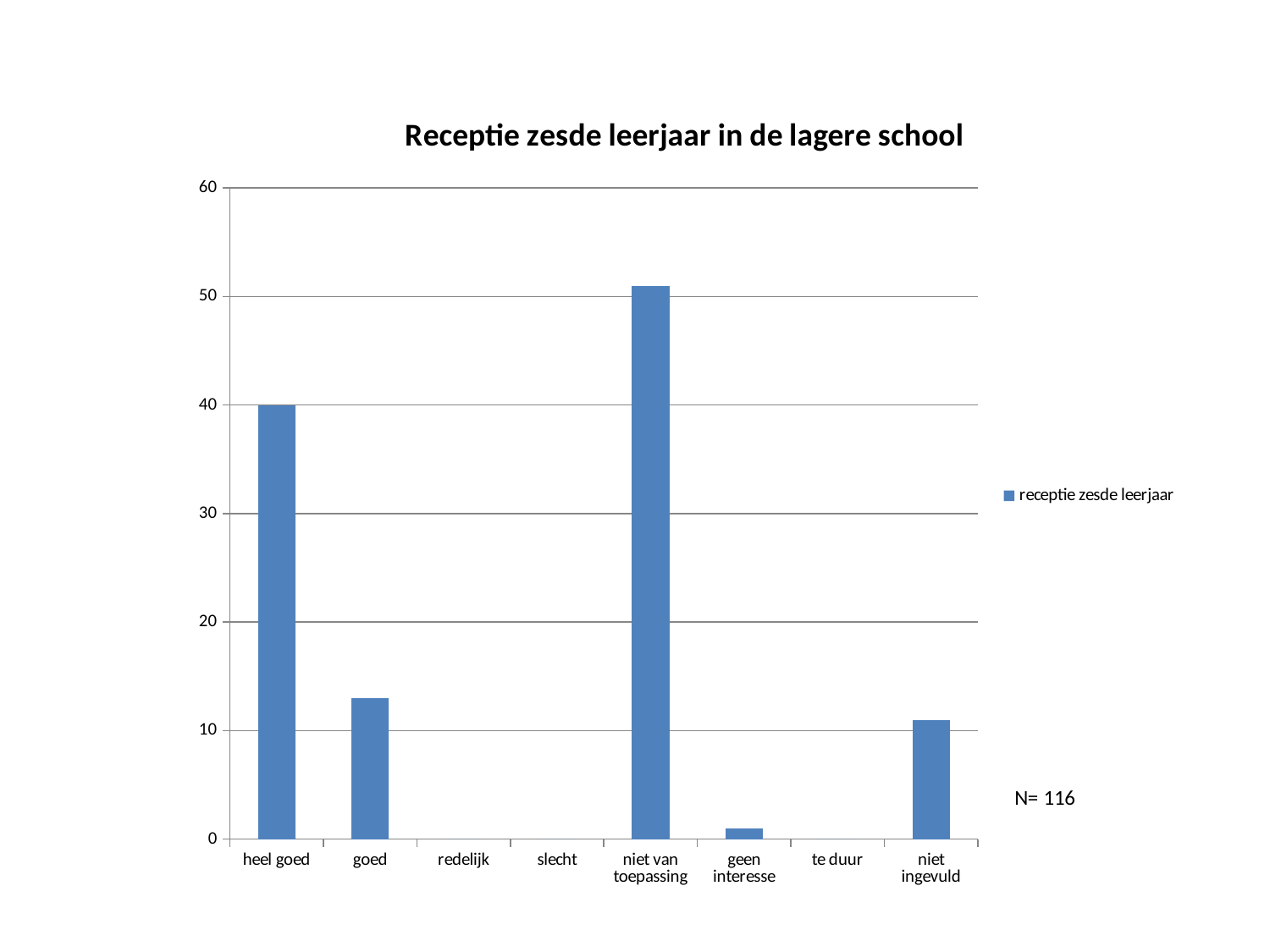
How many series does the legend list? 1 Is the value for 'geen interesse' greater or less than 10? less What is the value for 'heel goed'? 40 Is the value for 'niet van toepassing' greater or less than 50? greater What is the N value shown next to the chart? N= 116 Which category has the highest value? niet van toepassing What type of chart is shown on the slide? bar chart What is the title of the chart? Receptie zesde leerjaar in de lagere school Which is larger, the value for 'heel goed' or the value for 'goed'? heel goed How many categories are shown on the x axis? 8 Is the value for 'goed' greater or less than 10? greater What is the value for 'redelijk'? 0